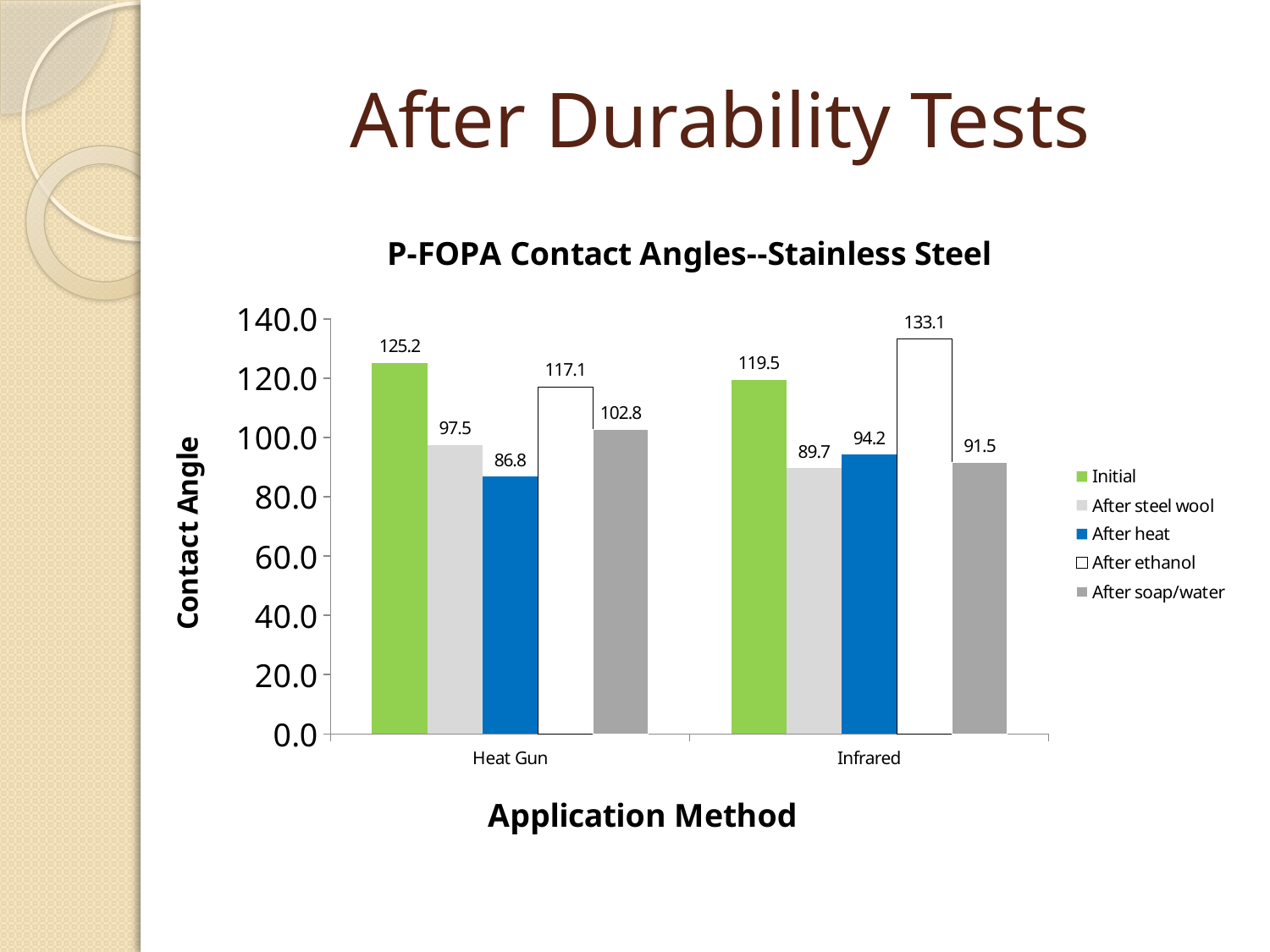
Which is larger: the After steel wool value for Heat Gun or for Infrared? Heat Gun What is the difference between the Initial values for Heat Gun and Infrared? 5.7 What is the After heat contact angle for Heat Gun? 86.8 What is the After ethanol contact angle for Infrared? 133.1 Which series has the lowest value for Heat Gun? After heat What is the title of the chart? P-FOPA Contact Angles--Stainless Steel What is the Initial contact angle for Heat Gun? 125.2 How many application methods are shown on the x axis? 2 What kind of chart is this? Bar chart Which series has the highest value for Infrared? After ethanol How many series does the legend list? 5 What is the After soap/water contact angle for Infrared? 91.5